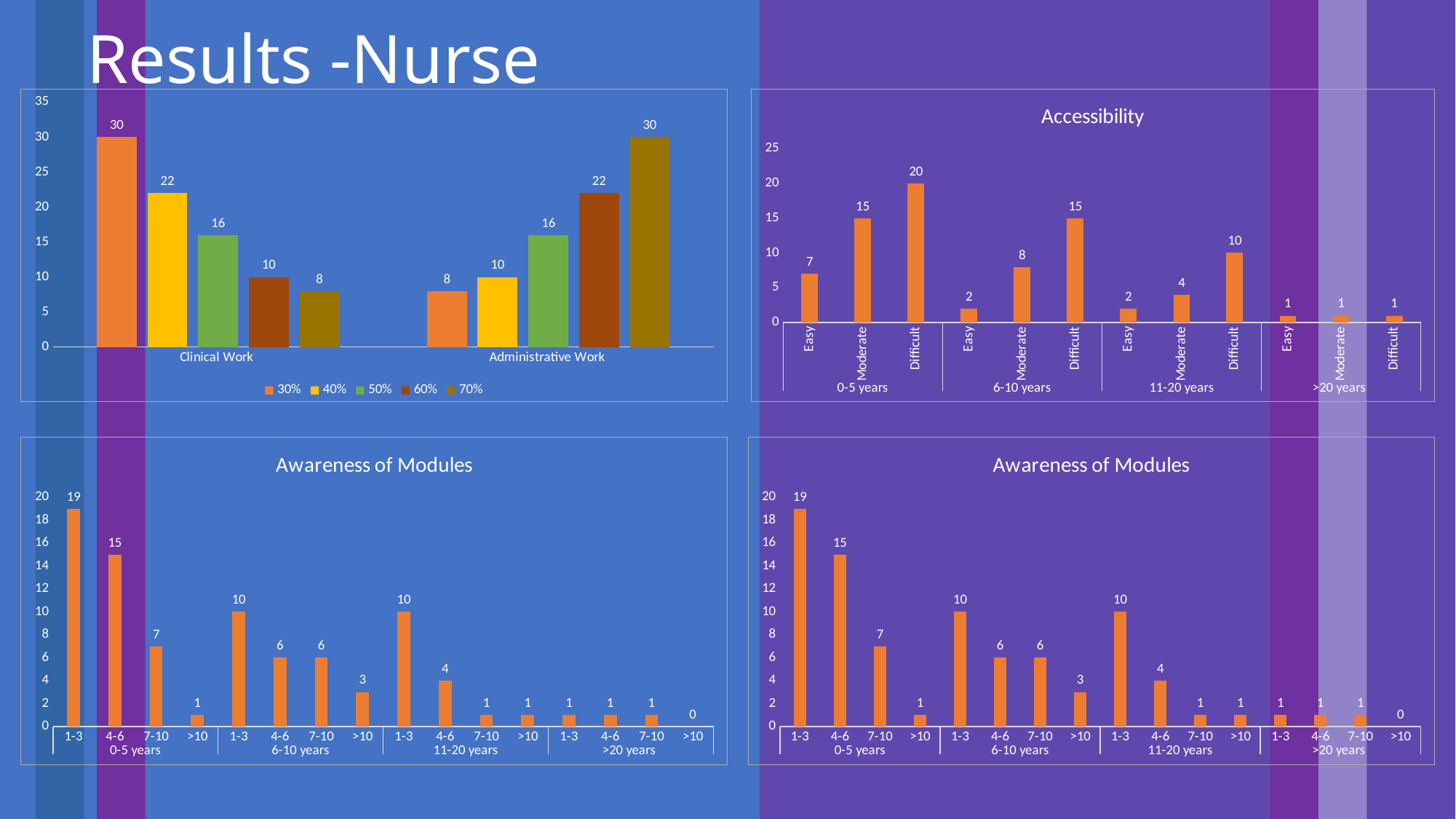
In the Accessibility chart, is the value for Moderate in the 6-10 years group larger than the value for Easy in the 6-10 years group? Yes What kind of chart is the bottom-right Awareness of Modules chart? Bar chart In the bottom-left Awareness of Modules chart, what is the value for 1-3 in the 0-5 years group? 19 In the Accessibility chart, which category has the highest value? Difficult (0-5 years) In the top-left chart, what is the difference between the 50% series value for Clinical Work and the 60% series value for Clinical Work? 6 In the top-left chart, which series has the lowest value for Administrative Work? 30% In the Accessibility chart, what is the value for Difficult in the 0-5 years group? 20 In the bottom-left Awareness of Modules chart, what is the value for >10 in the >20 years group? 0 In the top-left chart, how many series does the legend list? 5 In the top-left chart, what is the value of the 70% series for Administrative Work? 30 In the Accessibility chart, what is the difference between Difficult and Easy in the 11-20 years group? 8 In the top-left chart, what is the value of the 30% series for Clinical Work? 30